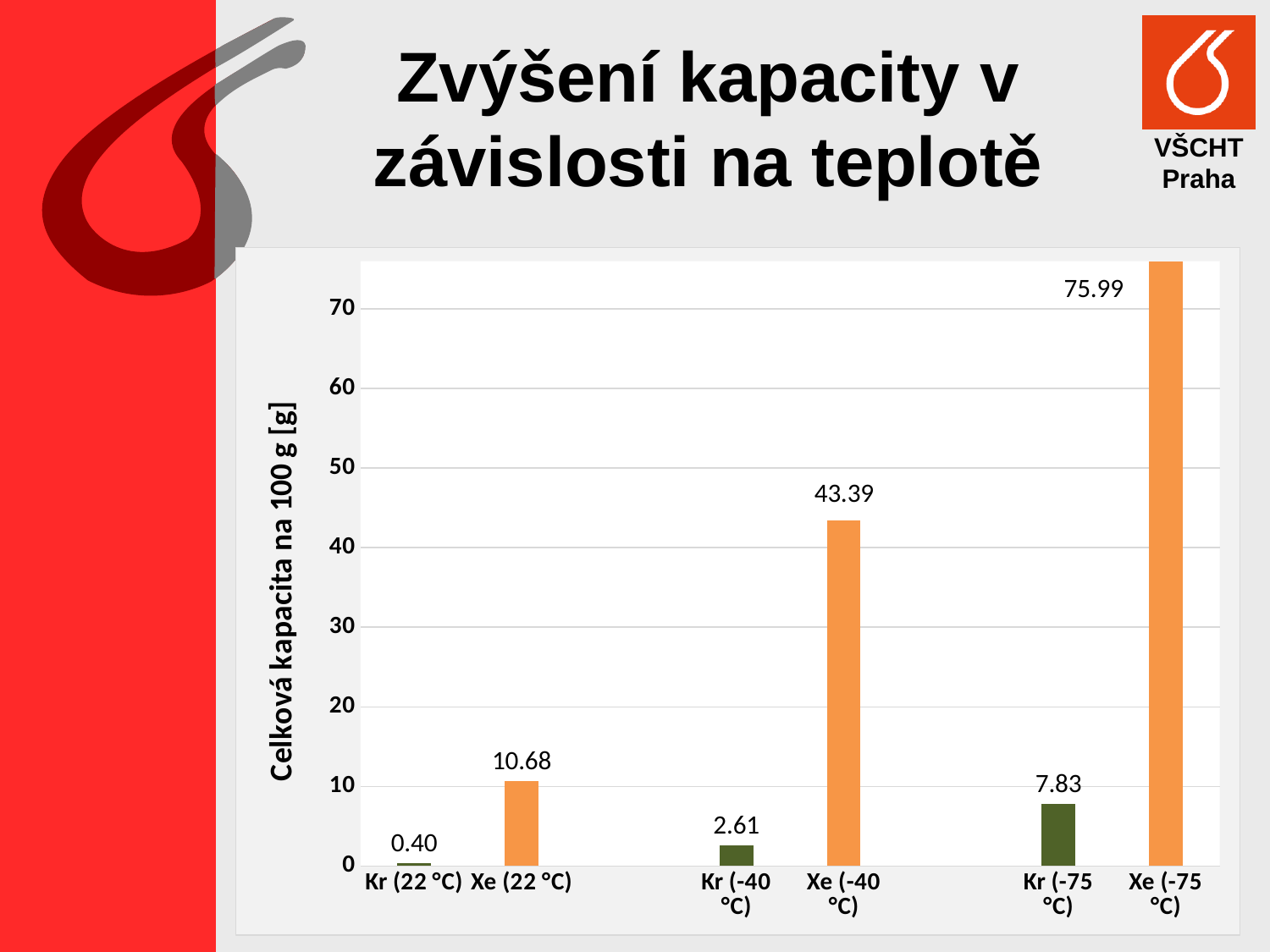
What is the difference between the values for Kr (-75 °C) and Kr (-40 °C)? 5.22 What kind of chart is shown on the slide? Bar chart What is the value for Xe (22 °C)? 10.68 What is the value for Kr (-75 °C)? 7.83 How many bars are shown in the chart? 6 What is the value for Kr (22 °C)? 0.40 Which is larger, the value for Xe (22 °C) or the value for Kr (-75 °C)? Xe (22 °C) What is the label of the vertical axis? Celková kapacita na 100 g [g] What is the difference between the values for Xe (-75 °C) and Xe (-40 °C)? 32.60 Which category has the highest value? Xe (-75 °C) Which category has the lowest value? Kr (22 °C) What is the value for Xe (-40 °C)? 43.39